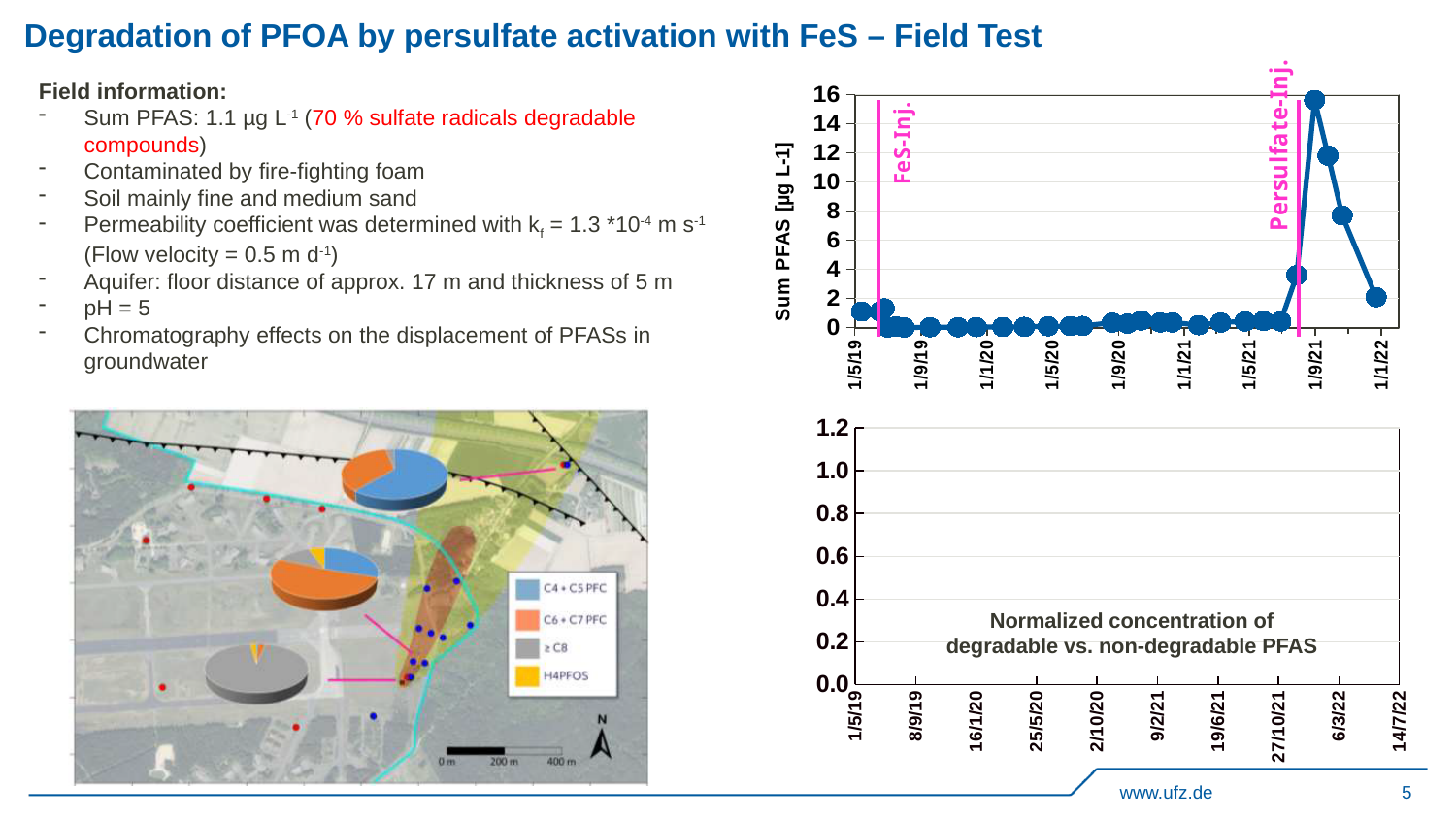
What kind of chart is the top-right chart showing Sum PFAS over time? line chart In the top-right Sum PFAS chart, is the last plotted value near 1/1/22 greater or less than 4? less In the top-right Sum PFAS chart, which injection marker appears first along the x axis? FeS-Inj. In the top-right Sum PFAS chart, are the values plotted between the FeS-Inj. and Persulfate-Inj. markers greater or less than 2? less In the top-right Sum PFAS chart, do the values rise or fall between 1/5/21 and 1/9/21? rise How many categories does the legend of the pie charts on the map list? 4 What text is written inside the bottom-right chart? Normalized concentration of degradable vs. non-degradable PFAS In the top-right Sum PFAS chart, do the values rise or fall between the peak near 1/9/21 and 1/1/22? fall In the top-right Sum PFAS chart, is the peak value reached shortly after the Persulfate-Inj. marker greater or less than 14? greater